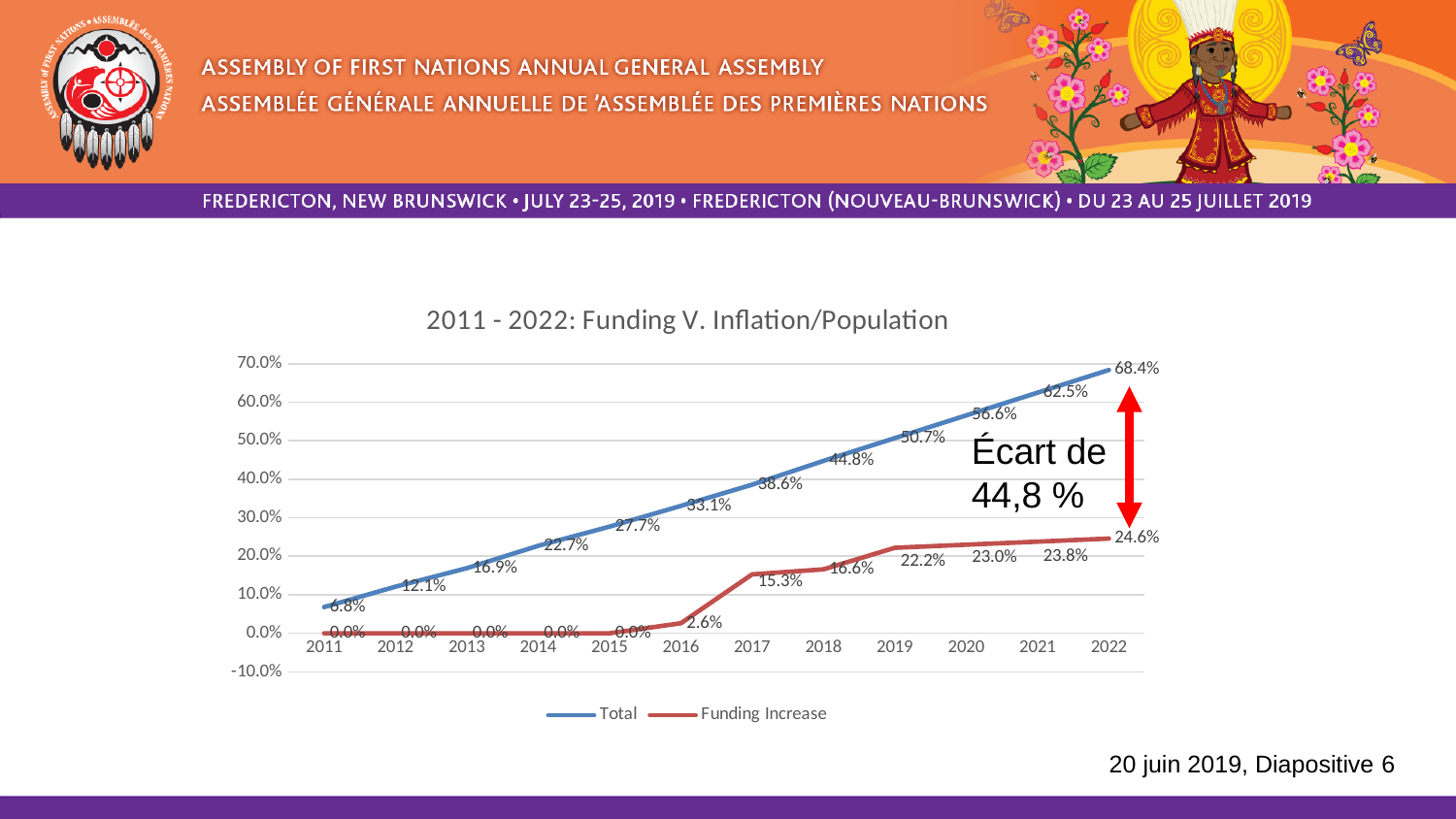
What is the lowest value of the Total series, and in which year does it occur? 6.8% in 2011 What is the value of the Total series in 2022? 68.4% What is the difference between the Total and Funding Increase values in 2019? 28.5% What is the title of the chart? 2011 - 2022: Funding V. Inflation/Population What is the value of the Total series in 2015? 27.7% How many years are shown on the x axis? 12 How many series does the legend list? 2 What is the value of the Funding Increase series in 2017? 15.3% Which series has the larger value in 2018, Total or Funding Increase? Total In which year is the Funding Increase series at its highest? 2022 Does the Total series rise or fall from 2011 to 2022? Rise What type of chart is shown on the slide? Line chart